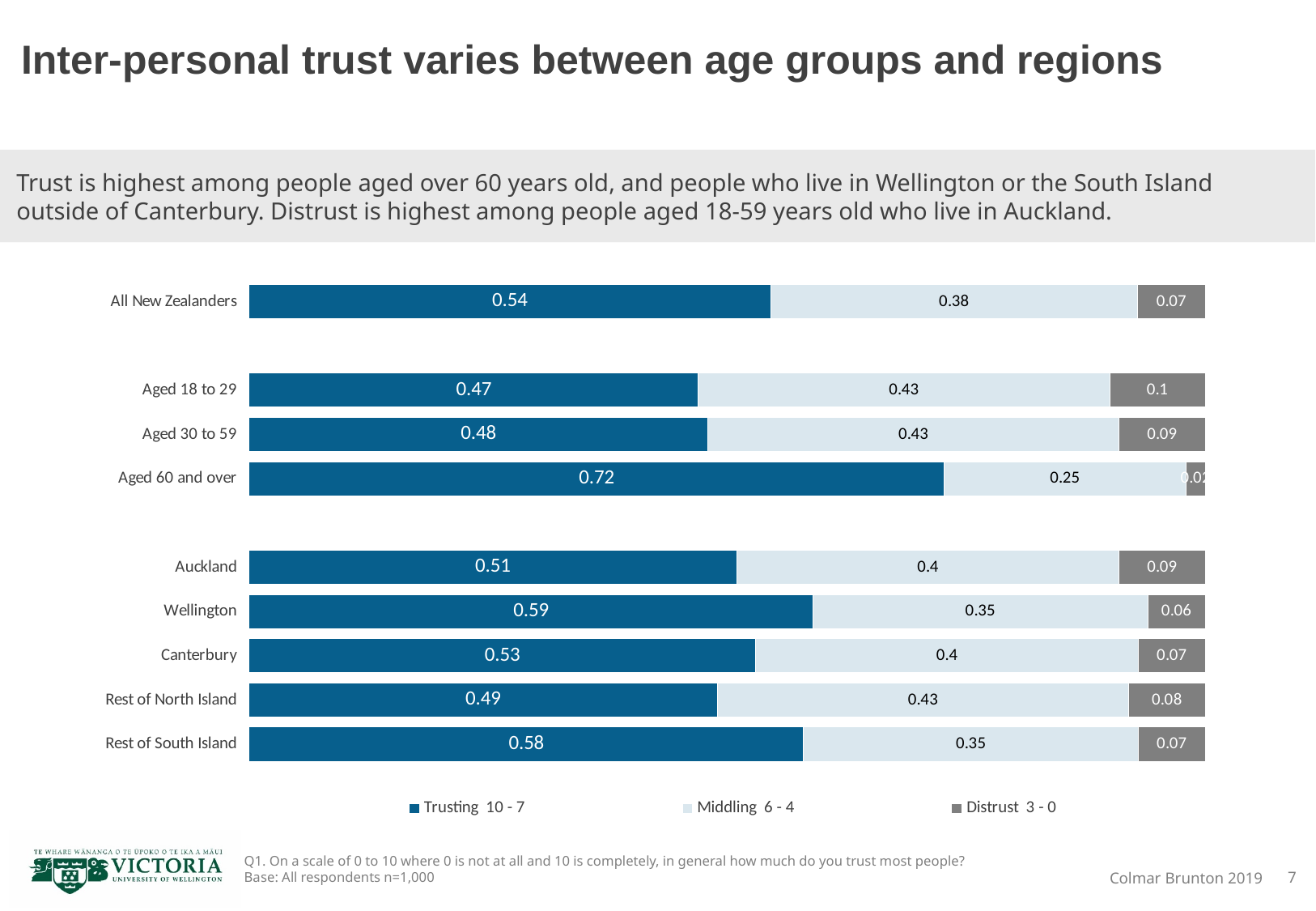
What is the difference between the Trusting 10 - 7 values for Aged 60 and over and Aged 18 to 29? 0.25 What is the Distrust 3 - 0 value for Aged 18 to 29? 0.1 What is the Middling 6 - 4 value for Aged 60 and over? 0.25 Which category has the lowest Trusting 10 - 7 value? Aged 18 to 29 What kind of chart is shown on the slide? Stacked bar chart Which category has the highest Trusting 10 - 7 value? Aged 60 and over What is the total of the stacked bar for Canterbury? 1 How many categories are shown in the chart? 9 What is the Trusting 10 - 7 value for Wellington? 0.59 Which has a larger Trusting 10 - 7 value, Auckland or Rest of South Island? Rest of South Island How many series does the legend list? 3 What is the Trusting 10 - 7 value for All New Zealanders? 0.54